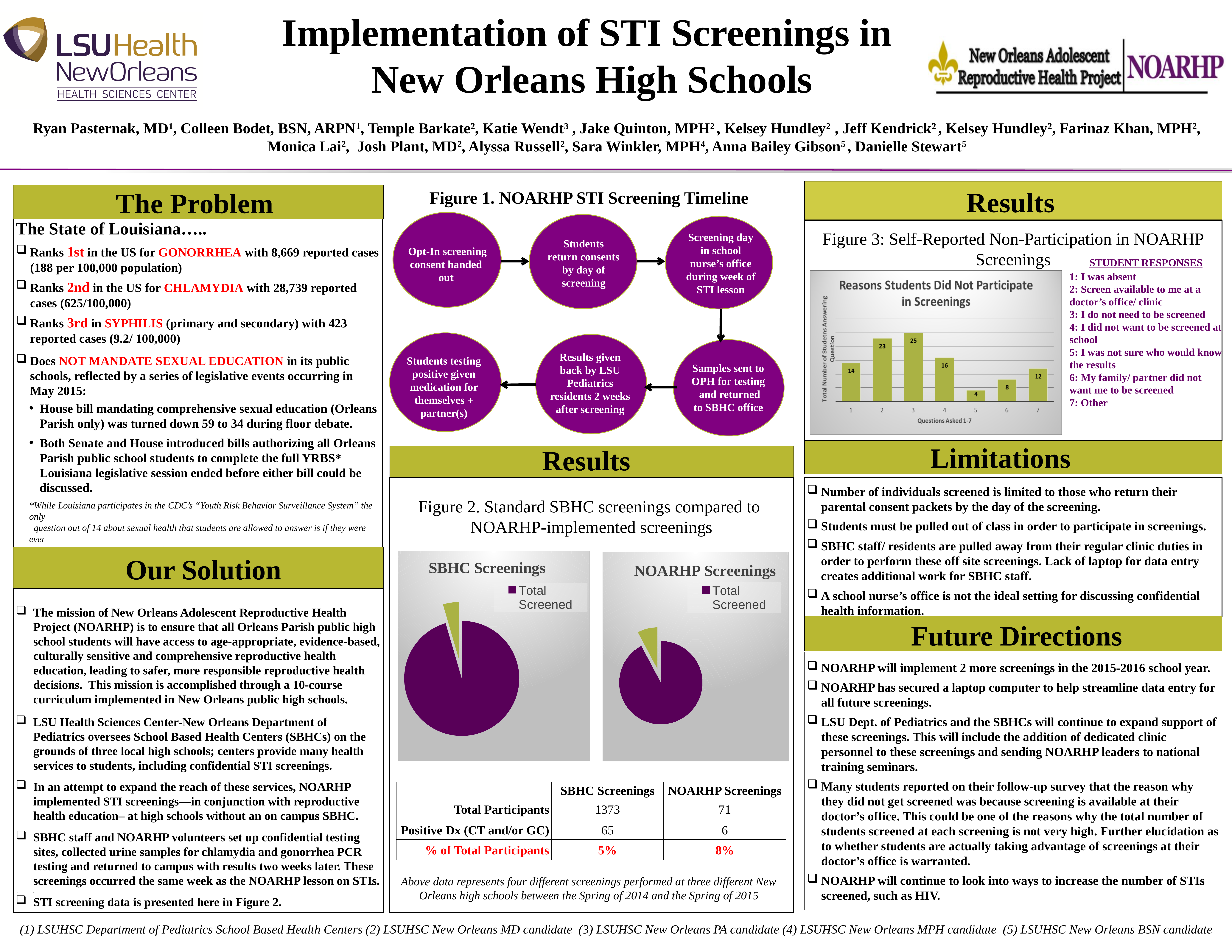
In the 'Reasons Students Did Not Participate in Screenings' chart, what is the difference between the values for question 1 and question 6? 6 In the 'Reasons Students Did Not Participate in Screenings' chart, which question has the lowest number of students answering? 5 What legend entry is shown on the 'NOARHP Screenings' pie chart? Total Screened What kind of chart is 'Reasons Students Did Not Participate in Screenings'? bar chart How many questions (categories) are shown on the x axis of the 'Reasons Students Did Not Participate in Screenings' chart? 7 In the 'Reasons Students Did Not Participate in Screenings' chart, what is the value for question 3? 25 In the 'Reasons Students Did Not Participate in Screenings' chart, what is the value for question 5? 4 In the 'Reasons Students Did Not Participate in Screenings' chart, what is the difference between the values for question 3 and question 2? 2 In the 'Reasons Students Did Not Participate in Screenings' chart, which question has the highest number of students answering? 3 What kind of chart is the 'SBHC Screenings' chart in Figure 2? pie chart In the 'Reasons Students Did Not Participate in Screenings' chart, what is the value for question 7? 12 In the 'Reasons Students Did Not Participate in Screenings' chart, which is larger, the value for question 4 or the value for question 7? question 4